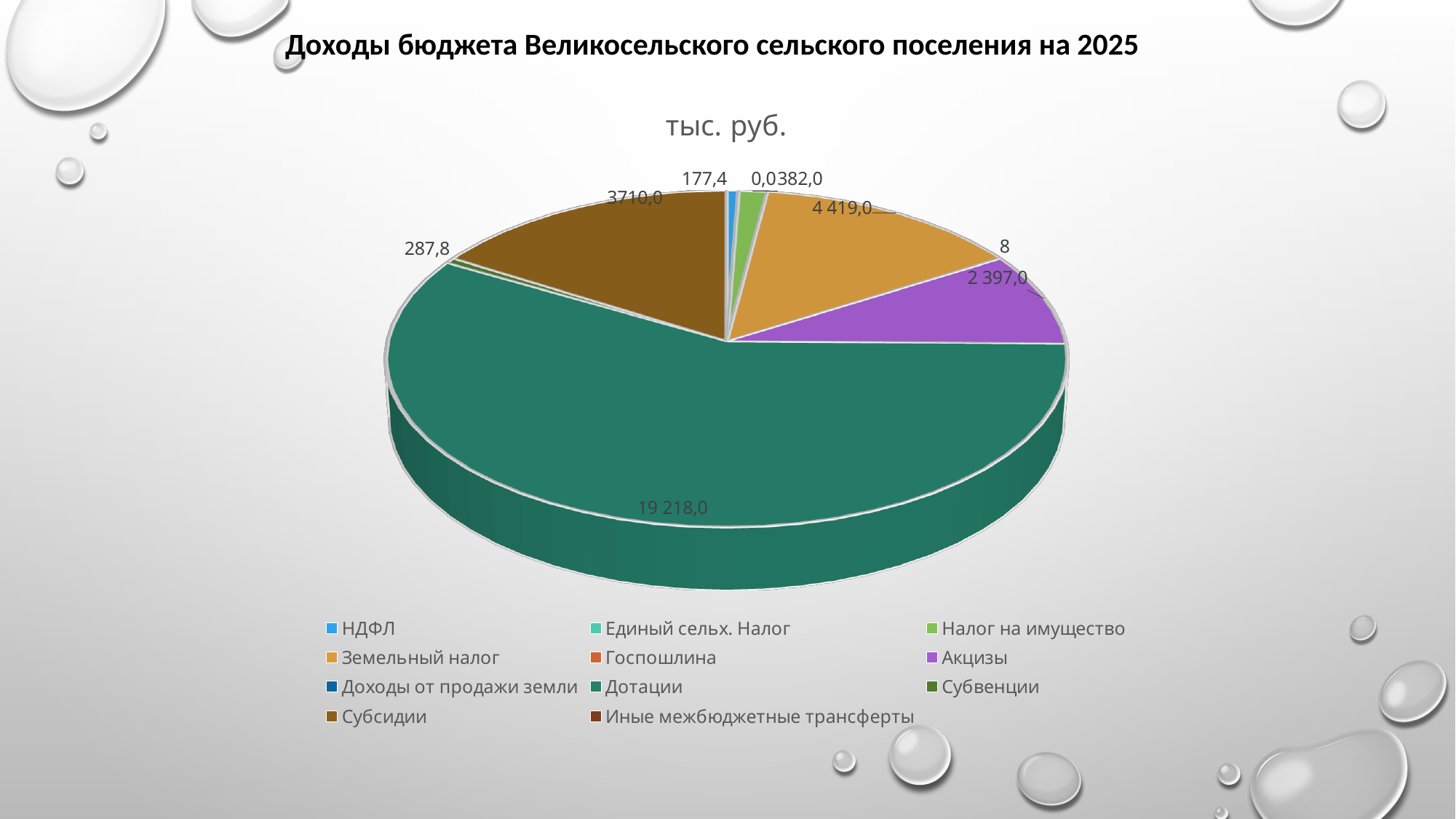
What is the value for Дотации? 19 218,0 What is the value for НДФЛ? 177,4 What is the difference between Земельный налог and Акцизы? 2 022,0 How many categories does the legend list? 11 What is the value for Субсидии? 3710,0 What is the value for Земельный налог? 4 419,0 What kind of chart is shown on the slide? pie chart What is the value for Акцизы? 2 397,0 What is the difference between Субсидии and Акцизы? 1 313,0 What is the title shown above the pie chart? тыс. руб. Which is larger, Земельный налог or Акцизы? Земельный налог Which category has the largest slice of the pie? Дотации